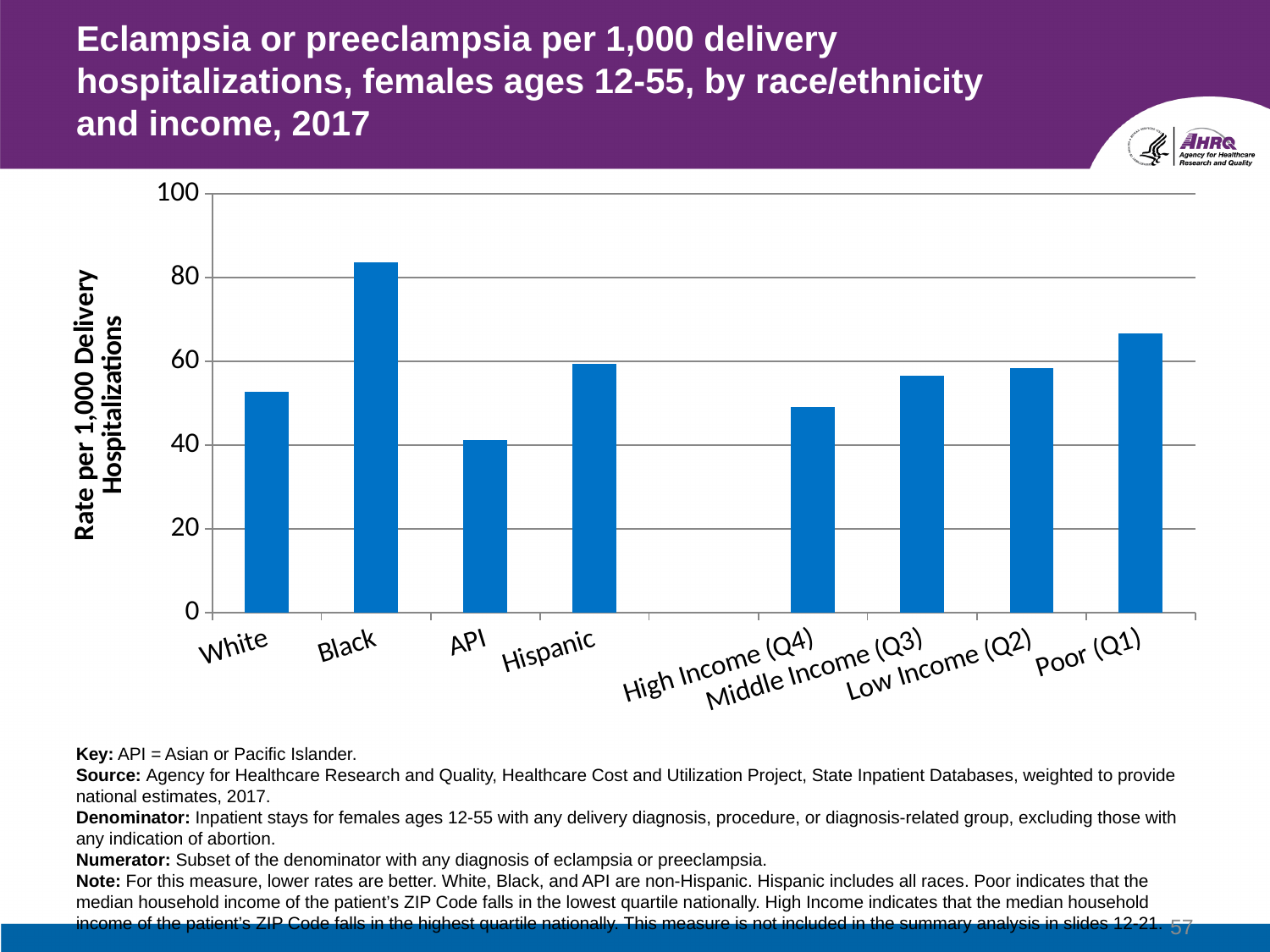
Is the value for High Income (Q4) greater or less than 60? less Is the value for Black greater or less than 80? greater Do the values rise or fall moving from High Income (Q4) to Poor (Q1) along the x axis? rise Which category has the lowest rate of eclampsia or preeclampsia per 1,000 delivery hospitalizations? API Which is larger, the value for Poor (Q1) or the value for High Income (Q4)? Poor (Q1) How many categories are plotted on the x axis? 8 What type of chart is shown on the slide? bar chart Which is larger, the value for White or the value for Black? Black What does API stand for according to the key on the slide? Asian or Pacific Islander Which category has the highest rate of eclampsia or preeclampsia per 1,000 delivery hospitalizations? Black Is the value for Poor (Q1) greater or less than 60? greater